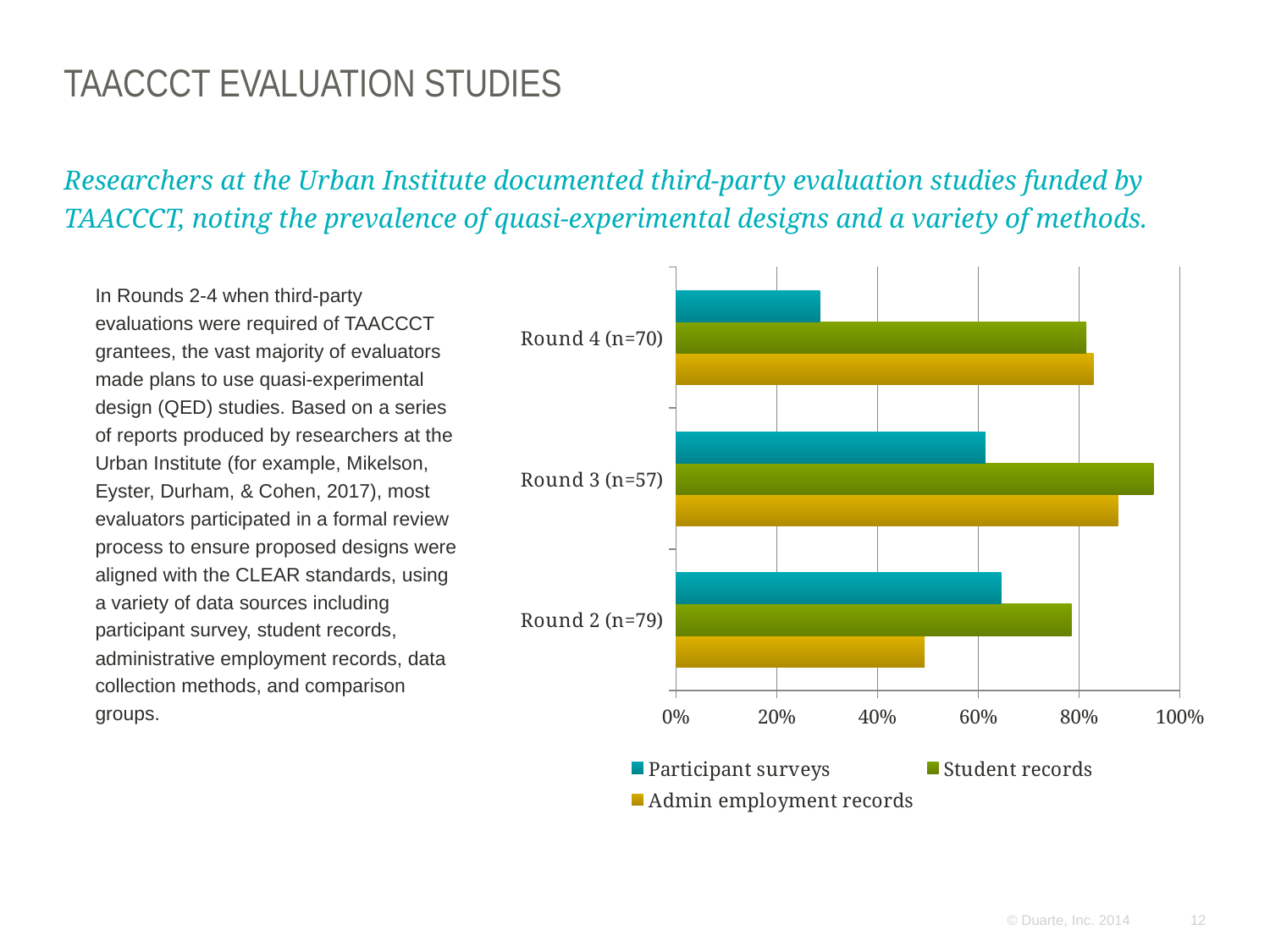
How many rounds (categories) are shown on the chart? 3 Is the value for Participant surveys in Round 4 (n=70) greater or less than 40%? less Which round has the highest value for Student records? Round 3 (n=57) Is the value for Student records in Round 3 (n=57) greater or less than 80%? greater In Round 2 (n=79), which is larger: Student records or Admin employment records? Student records Is the value for Student records in Round 4 (n=70) greater or less than 60%? greater What kind of chart is shown on the slide? Bar chart Which round has the lowest value for Participant surveys? Round 4 (n=70) Which round has the lowest value for Admin employment records? Round 2 (n=79) Which series is shown in the teal/blue colour in the legend? Participant surveys How many series does the chart's legend list? 3